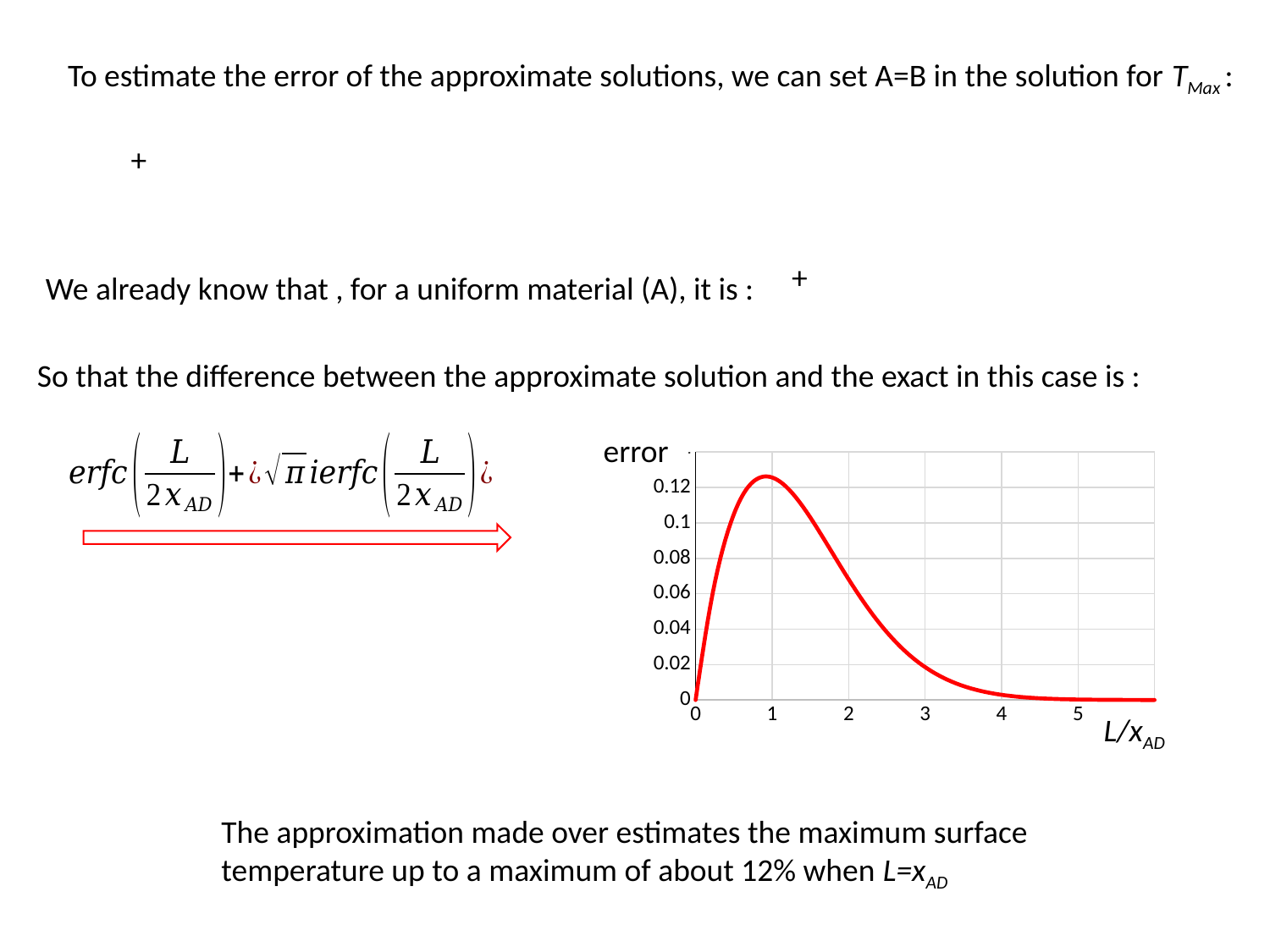
What is the error value at L/x_AD = 0? 0 Is the error value at L/x_AD = 4 greater or less than 0.02? less Is the error value at L/x_AD = 1 greater or less than 0.1? greater Is the error value at L/x_AD = 3 greater or less than 0.04? less What is the label on the horizontal axis of the chart? L/x_AD Which is larger, the error at L/x_AD = 1 or the error at L/x_AD = 3? L/x_AD = 1 What is the label on the vertical axis of the chart? error What kind of chart is shown on the slide? line chart How does the error change as L/x_AD increases from 1 to 5? it falls What is the highest value shown on the vertical axis of the chart? 0.12